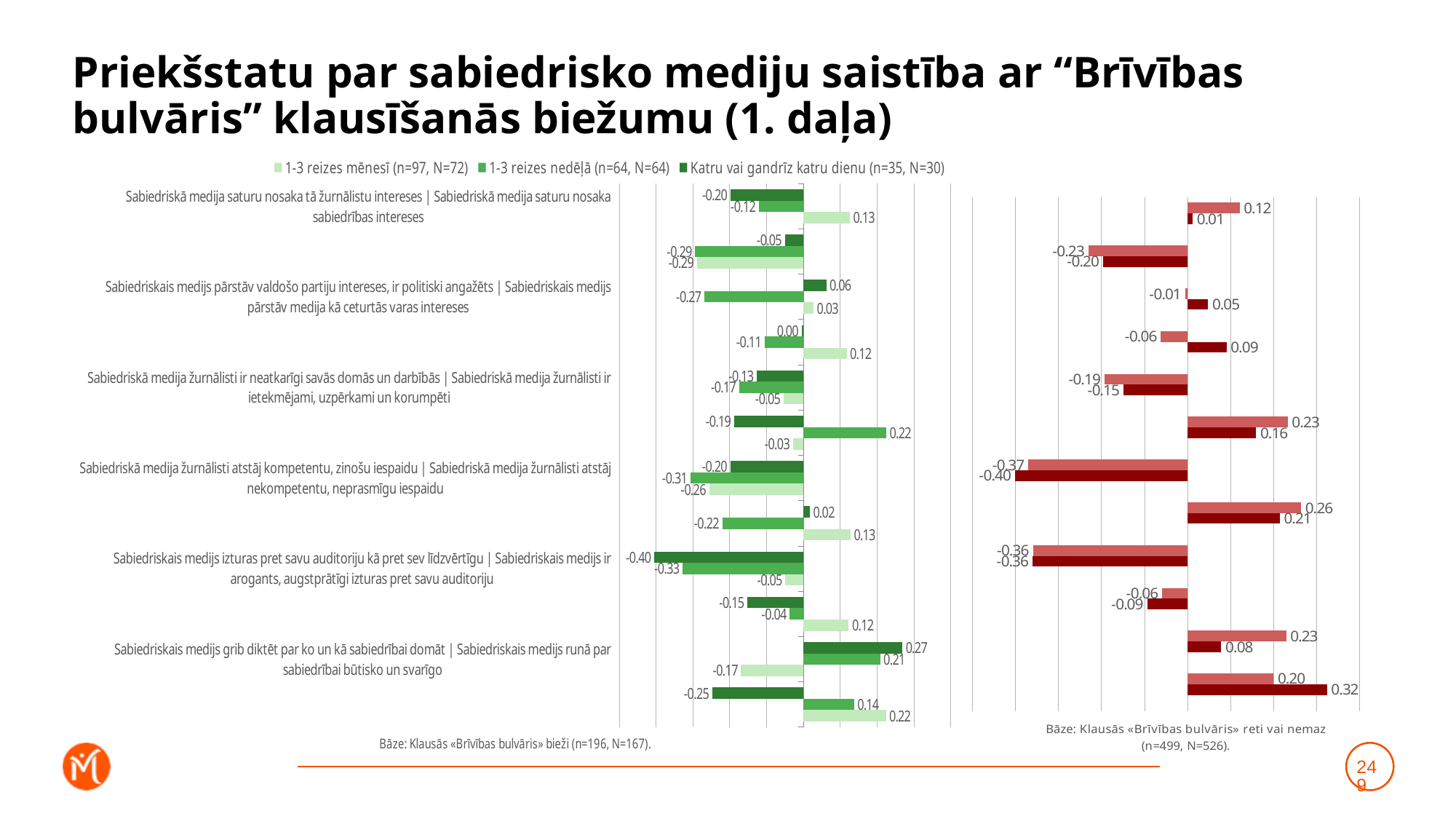
What is the third legend entry above the left (green) chart? Katru vai gandrīz katru dienu (n=35, N=30) In the left (green) chart, what is the value of the dark green bar in the topmost group of bars? -0.20 In the right (red) chart, what is the highest value printed on any bar? 0.32 What is the first legend entry above the left (green) chart? 1-3 reizes mēnesī (n=97, N=72) In the right (red) chart, which bar in the bottommost group is larger: the dark red bar (0.32) or the light red bar (0.20)? the dark red bar (0.32) How many series does the legend above the left (green) chart list? 3 In the left (green) chart, what is the difference between the light green bar (0.13) and the dark green bar (-0.20) in the topmost group? 0.33 In the left (green) chart, what is the highest value printed on any bar? 0.27 What kind of chart is the left (green) chart on the slide? bar chart In the left (green) chart, what is the lowest value printed on any bar? -0.40 In the left (green) chart, what is the value of the light green bar in the topmost group of bars? 0.13 In the right (red) chart, what is the lowest value printed on any bar? -0.40